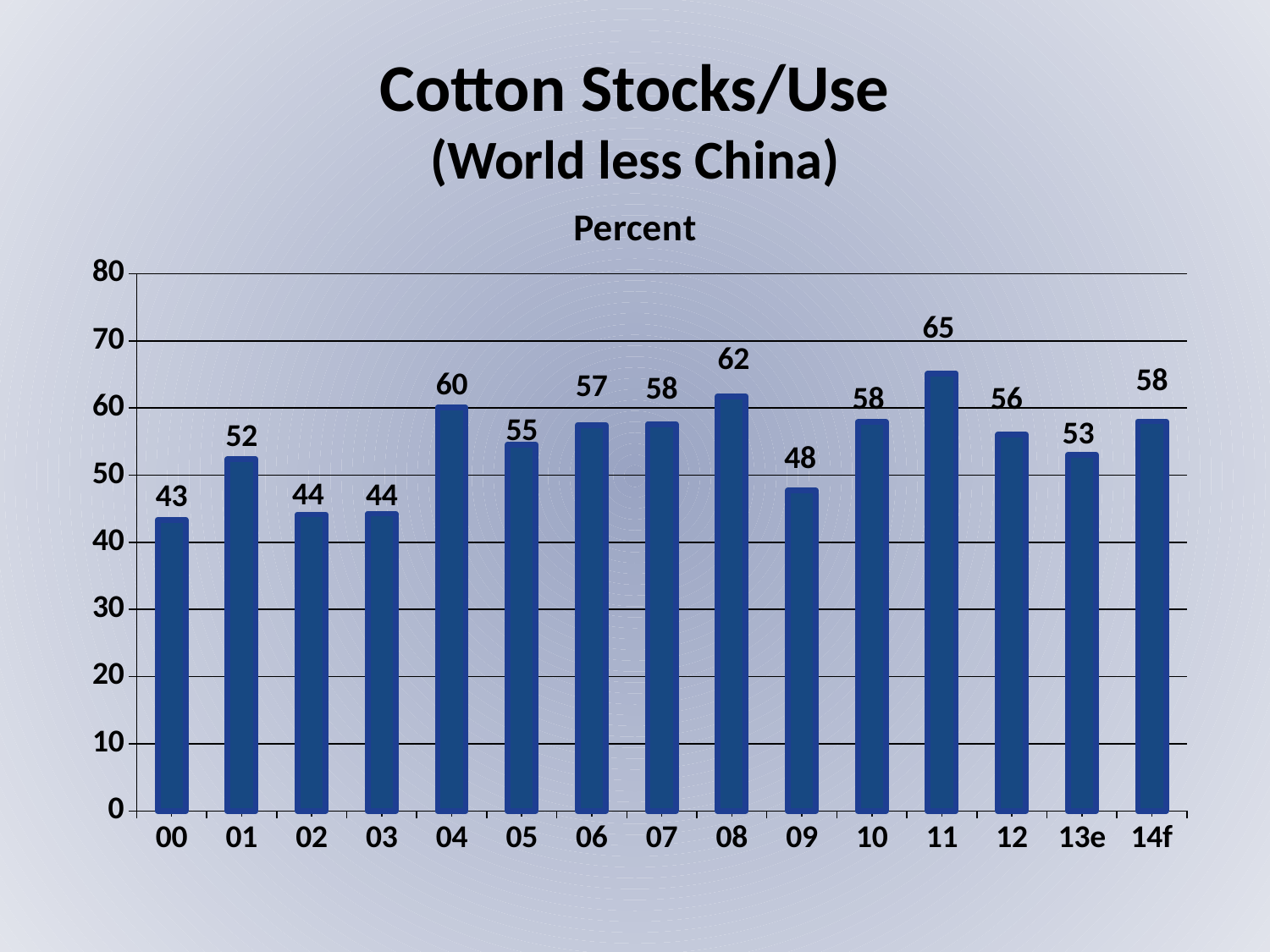
What unit is indicated above the chart? Percent What kind of chart is shown on the slide? bar chart Which year has the highest stocks/use value? 11 What is the value shown for 00? 43 What is the cotton stocks/use value for 11? 65 What is the difference between the values for 11 and 09? 17 Is the value for 08 greater or less than 60? greater How many years are shown on the x axis? 15 What is the value shown for 13e? 53 Which year has the lowest stocks/use value? 00 Do the values rise or fall from 00 to 04? rise Which is larger, the value for 04 or the value for 05? 04